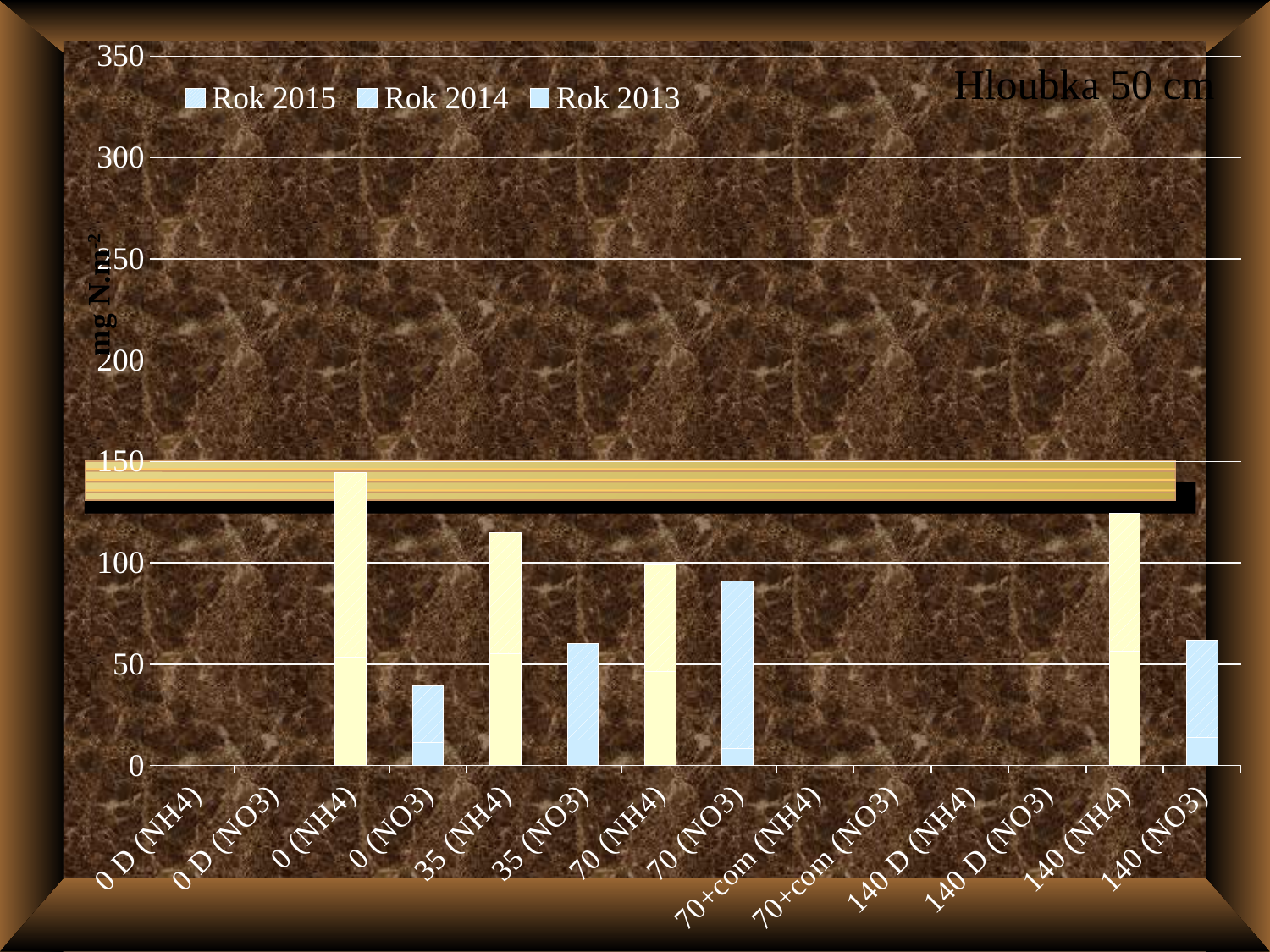
Is the value for 0 (NH4) greater or less than 100? greater Which is larger, the value for 140 (NH4) or the value for 140 (NO3)? 140 (NH4) What is the title of the chart? Hloubka 50 cm Is the value for 140 (NH4) greater or less than 100? greater Is the value for 35 (NH4) greater or less than 100? greater How many categories are shown on the x axis? 14 How many series does the legend list? 3 Which is larger, the value for 35 (NH4) or the value for 35 (NO3)? 35 (NH4) Which category has the highest bar? 0 (NH4) What type of chart is shown on the slide? bar chart